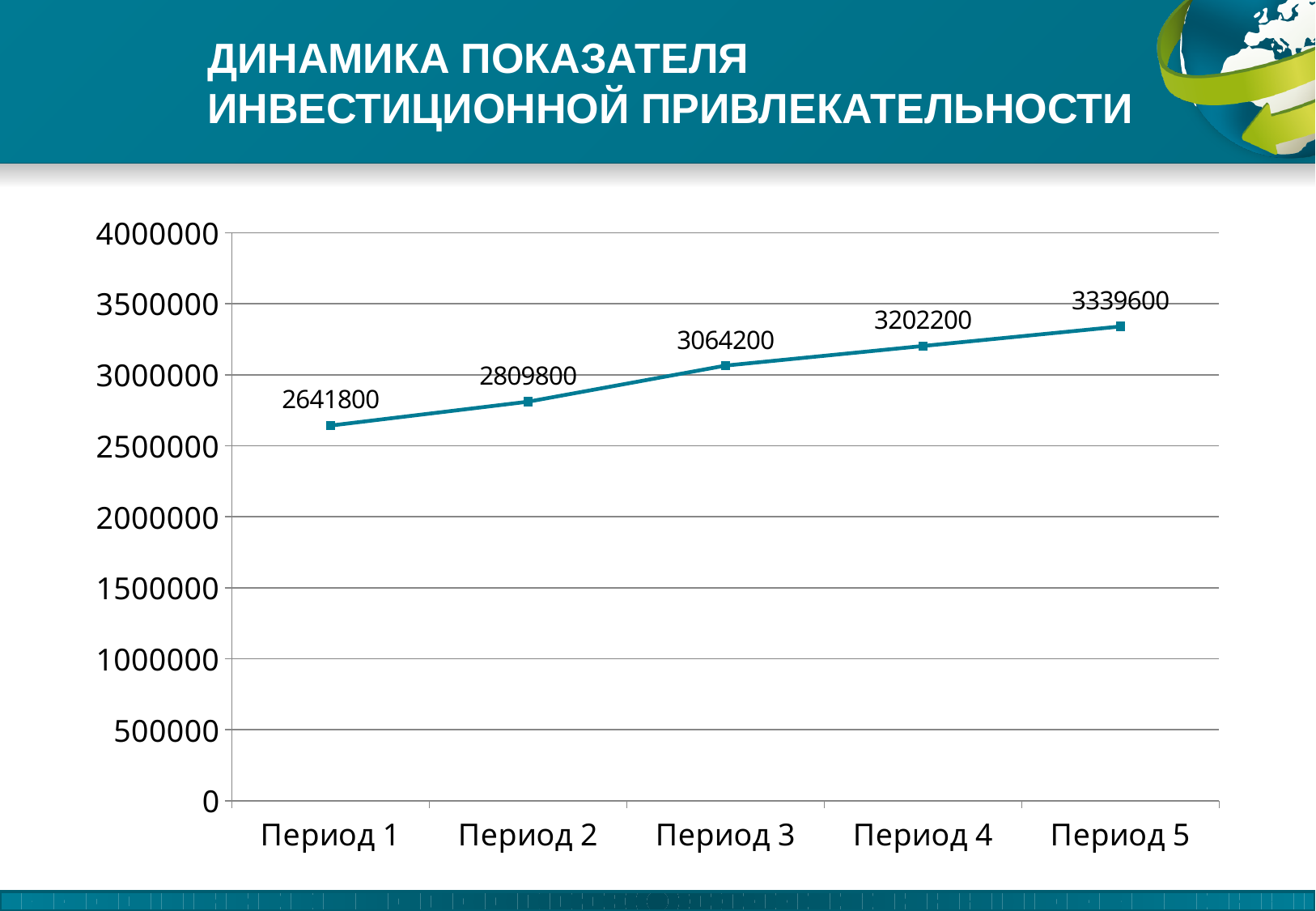
Do the values rise or fall from Период 1 to Период 5? rise What is the value for Период 5? 3339600 Which period has the lowest value? Период 1 What is the difference between the values for Период 5 and Период 1? 697800 What is the difference between the values for Период 4 and Период 3? 138000 What is the value for Период 3? 3064200 What kind of chart is shown on the slide? line chart What is the value for Период 1? 2641800 Is the value for Период 2 greater or less than 3000000? less Which is larger, the value for Период 2 or the value for Период 4? Период 4 How many periods are plotted on the chart? 5 Which period has the highest value? Период 5